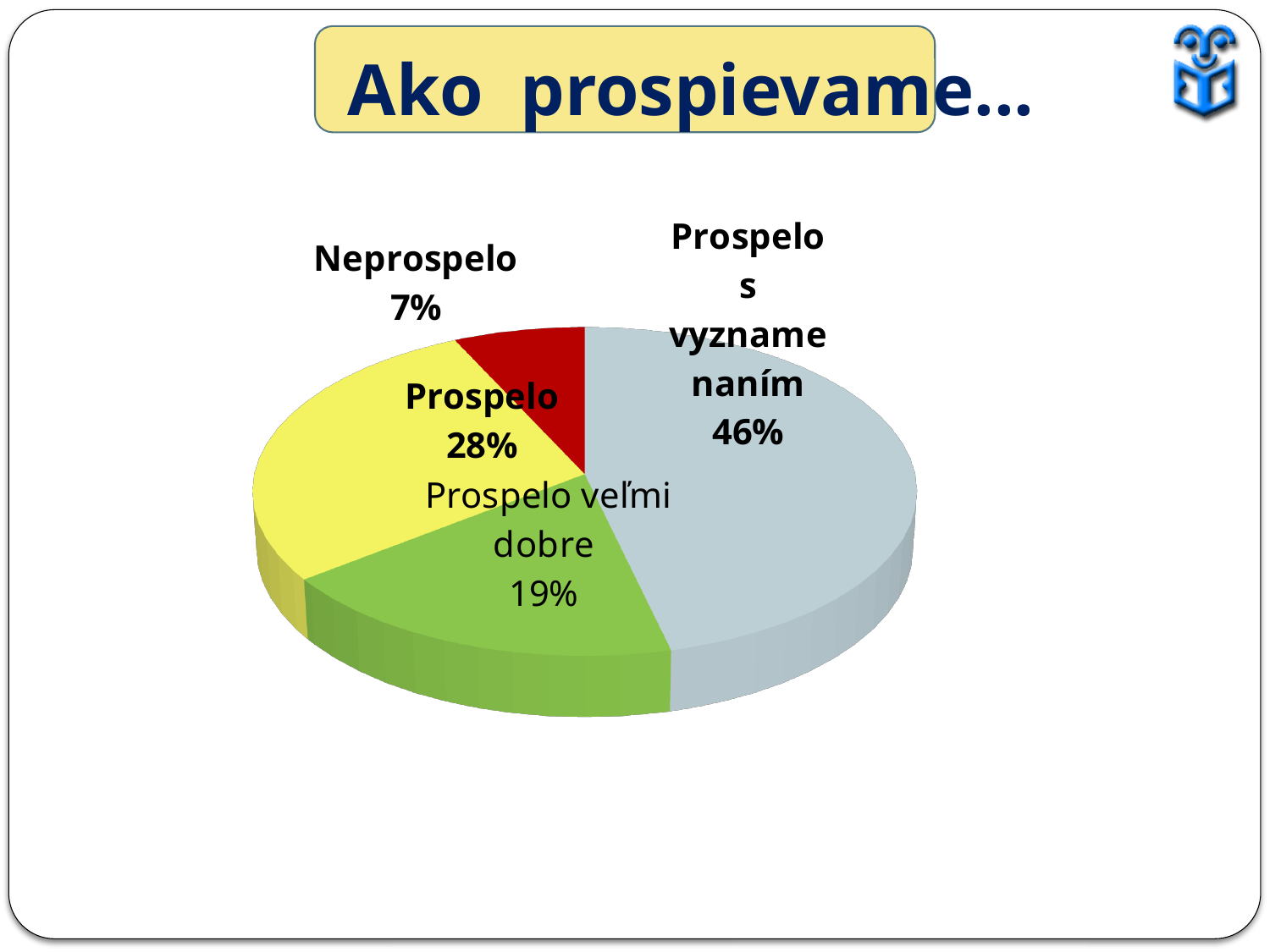
What share of the pie is labelled "Prospelo veľmi dobre"? 19% Which slice of the pie is the largest? Prospelo s vyznamenaním How many slices does the pie chart have? 4 Which slice of the pie is the smallest? Neprospelo What share of the pie is labelled "Prospelo s vyznamenaním"? 46% What kind of chart is shown on the slide? pie chart What share of the pie is labelled "Neprospelo"? 7% What is the difference in percentage points between "Prospelo s vyznamenaním" and "Prospelo"? 18 What colour is the "Neprospelo" slice of the pie? red What share of the pie is labelled "Prospelo"? 28% What is the difference in percentage points between "Prospelo veľmi dobre" and "Neprospelo"? 12 Which is larger, the share for "Prospelo" or the share for "Prospelo veľmi dobre"? Prospelo